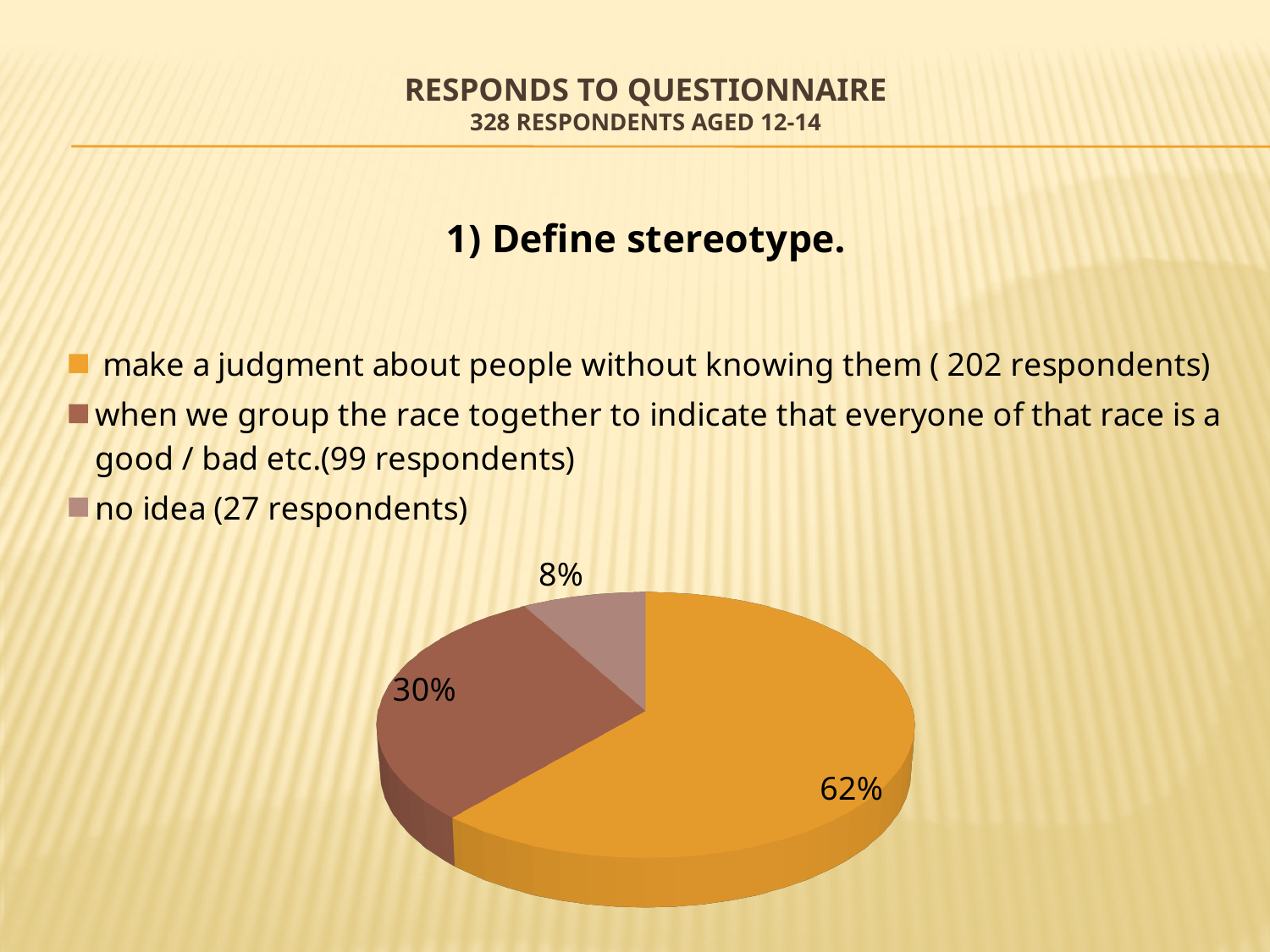
How many entries does the legend list? 3 What is the chart's title? 1) Define stereotype. What colour is the slice for "no idea"? light brown / tan What is the difference in percentage points between the largest slice (62%) and the "no idea" slice (8%)? 54 What kind of chart is shown on the slide? pie chart What percentage of the pie is the slice for "make a judgment about people without knowing them"? 62% Which category has the smallest slice of the pie? no idea What percentage of the pie is the slice for "when we group the race together to indicate that everyone of that race is a good / bad etc."? 30% What percentage of the pie is the slice for "no idea"? 8% Which slice is larger: "no idea" or "when we group the race together to indicate that everyone of that race is a good / bad etc."? when we group the race together to indicate that everyone of that race is a good / bad etc. Which category has the largest slice of the pie? make a judgment about people without knowing them How many slices does the pie chart have? 3